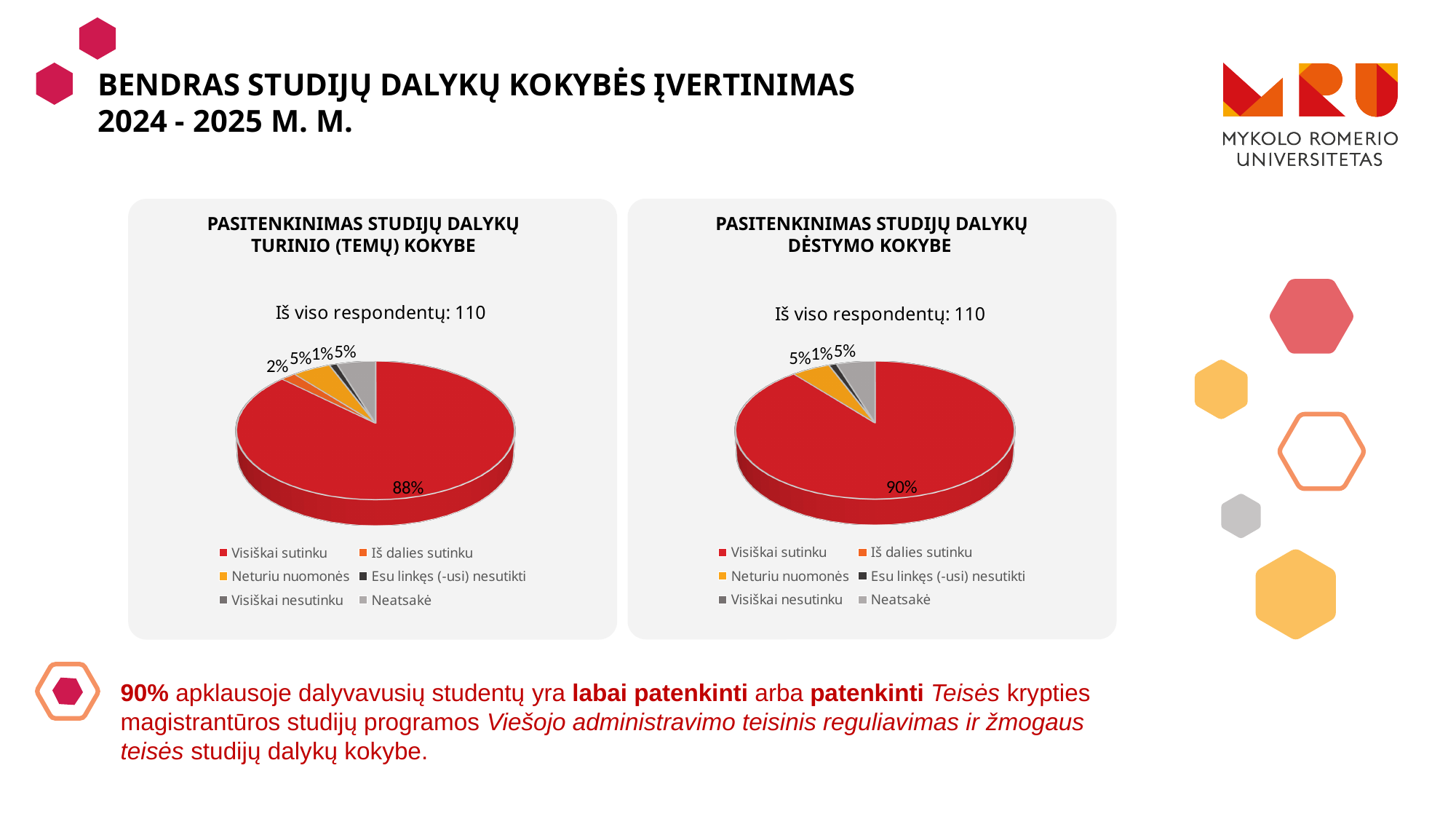
In the chart 'PASITENKINIMAS STUDIJŲ DALYKŲ DĖSTYMO KOKYBE', what share is labelled for 'Neturiu nuomonės'? 5% In the chart 'PASITENKINIMAS STUDIJŲ DALYKŲ TURINIO (TEMŲ) KOKYBE', which category has the largest slice? Visiškai sutinku How many respondents in total are stated for the chart 'PASITENKINIMAS STUDIJŲ DALYKŲ TURINIO (TEMŲ) KOKYBE'? 110 In the chart 'PASITENKINIMAS STUDIJŲ DALYKŲ TURINIO (TEMŲ) KOKYBE', what colour is the slice for 'Visiškai sutinku'? Red How many entries does the legend of the chart 'PASITENKINIMAS STUDIJŲ DALYKŲ DĖSTYMO KOKYBE' list? 6 In the chart 'PASITENKINIMAS STUDIJŲ DALYKŲ DĖSTYMO KOKYBE', what share is labelled for 'Esu linkęs (-usi) nesutikti'? 1% In the chart 'PASITENKINIMAS STUDIJŲ DALYKŲ TURINIO (TEMŲ) KOKYBE', what share is labelled for 'Visiškai sutinku'? 88% Which chart shows a larger share for 'Visiškai sutinku': 'PASITENKINIMAS STUDIJŲ DALYKŲ TURINIO (TEMŲ) KOKYBE' or 'PASITENKINIMAS STUDIJŲ DALYKŲ DĖSTYMO KOKYBE'? PASITENKINIMAS STUDIJŲ DALYKŲ DĖSTYMO KOKYBE What is the difference between the 'Visiškai sutinku' share in the 'DĖSTYMO KOKYBE' chart and the 'Visiškai sutinku' share in the 'TURINIO (TEMŲ) KOKYBE' chart? 2% What type of chart is used on the slide for 'PASITENKINIMAS STUDIJŲ DALYKŲ TURINIO (TEMŲ) KOKYBE'? Pie chart In the chart 'PASITENKINIMAS STUDIJŲ DALYKŲ TURINIO (TEMŲ) KOKYBE', what share is labelled for 'Iš dalies sutinku'? 2% In the chart 'PASITENKINIMAS STUDIJŲ DALYKŲ DĖSTYMO KOKYBE', what share is labelled for 'Visiškai sutinku'? 90%